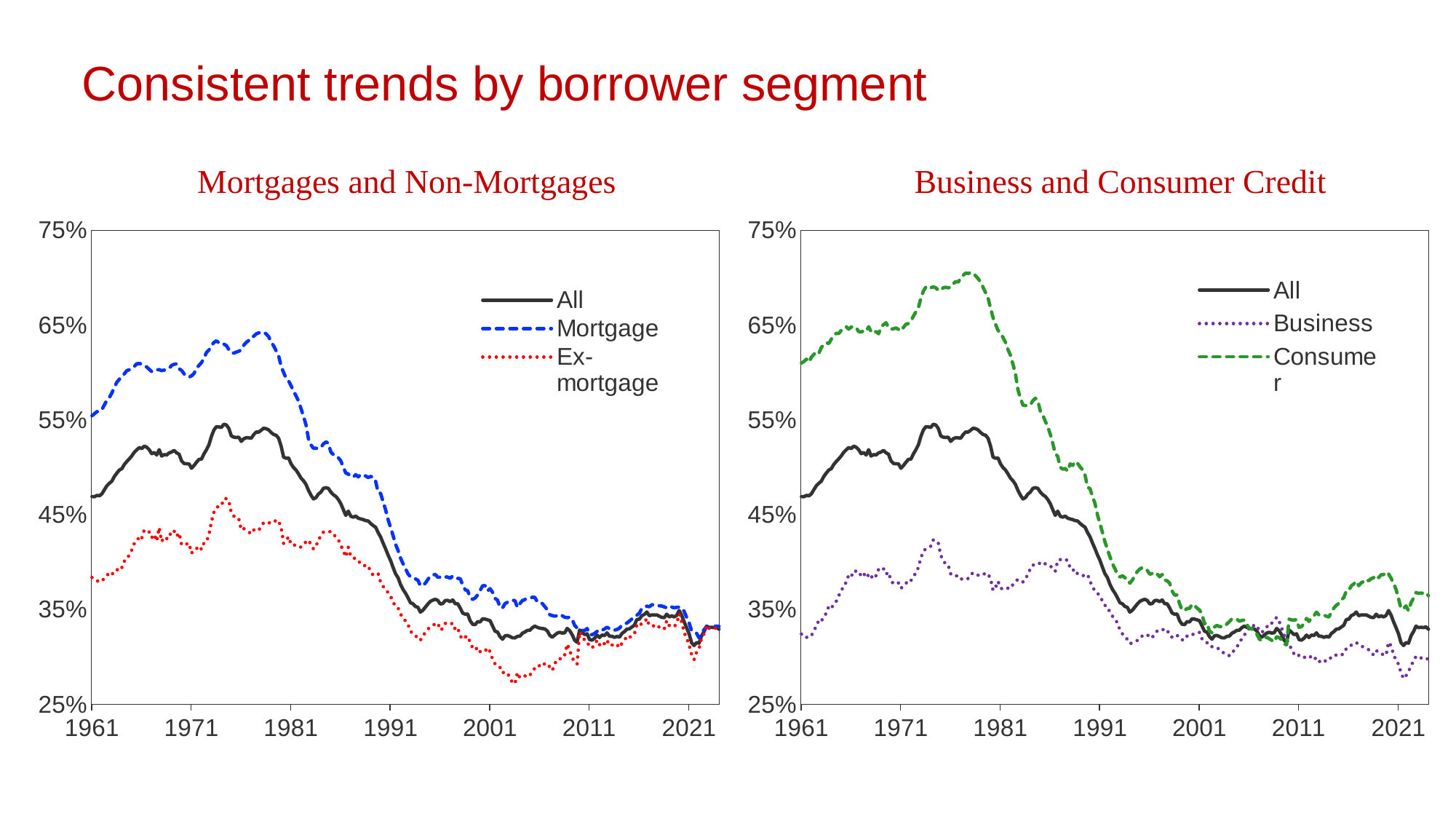
How many series does the legend of the "Business and Consumer Credit" chart list? 3 In the "Mortgages and Non-Mortgages" chart, which series are listed in the legend? All, Mortgage, Ex-mortgage In the "Mortgages and Non-Mortgages" chart, which series is higher in 1981, Mortgage or Ex-mortgage? Mortgage In the "Business and Consumer Credit" chart, is the peak value of the Consumer series greater or less than 65%? greater In the "Business and Consumer Credit" chart, does the Consumer series rise or fall between 1961 and 1978? Rise In the "Business and Consumer Credit" chart, is the Business value in 1961 greater or less than 35%? less In the "Mortgages and Non-Mortgages" chart, what colour is the Mortgage line? Blue In the "Business and Consumer Credit" chart, does the All series rise or fall between 1981 and 2001? Fall In the "Mortgages and Non-Mortgages" chart, is the Ex-mortgage value in 1961 greater or less than 45%? less In the "Business and Consumer Credit" chart, which series is higher in 1971, Business or Consumer? Consumer What kind of chart is the "Mortgages and Non-Mortgages" chart? Line chart